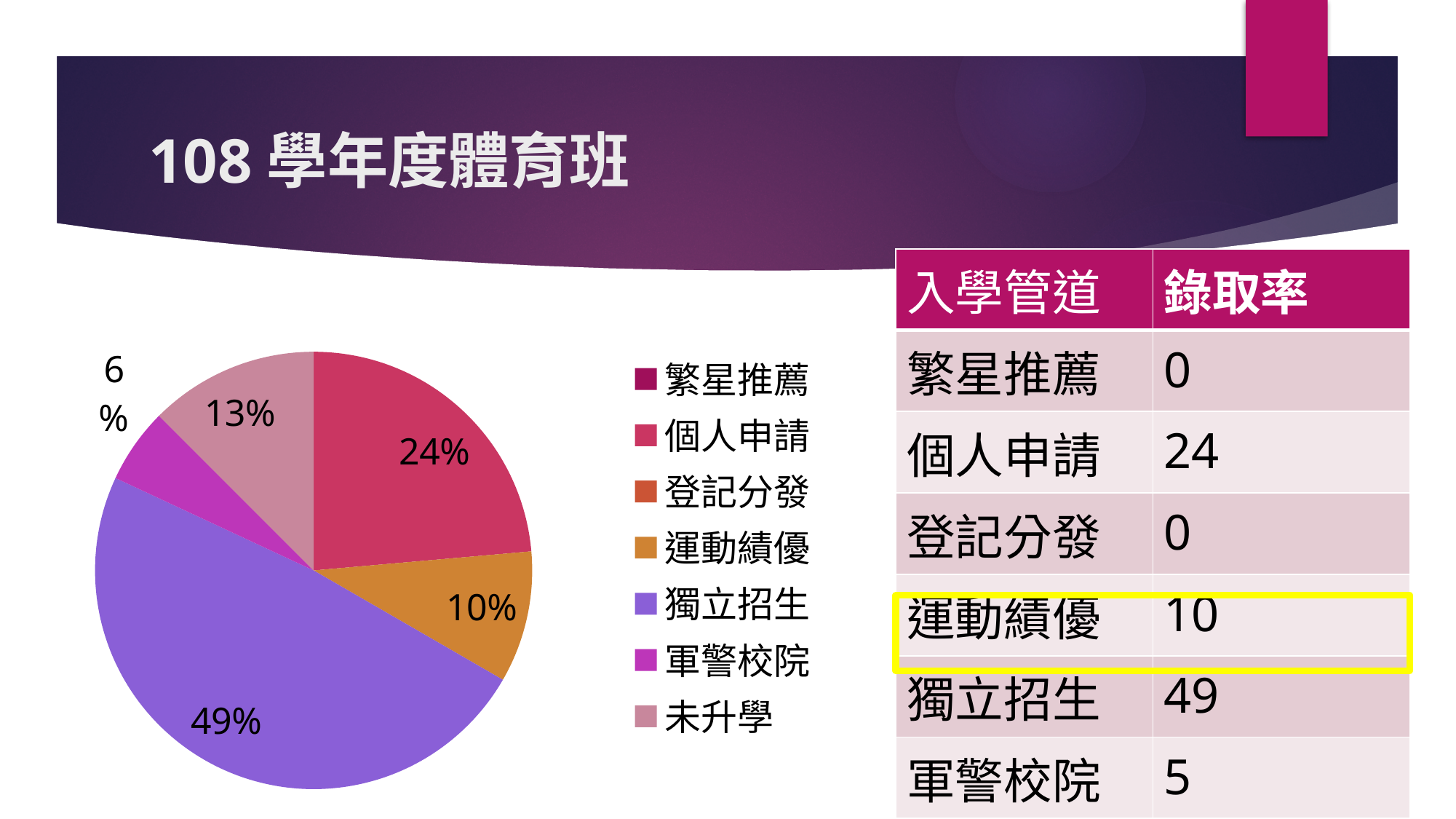
What type of chart is shown on the slide? pie chart What is the difference in percentage points between the 獨立招生 slice and the 個人申請 slice? 25% What percentage is shown for 運動績優 in the pie chart? 10% What is the title of the slide containing the pie chart? 108 學年度體育班 What percentage of the pie chart does 獨立招生 account for? 49% Which category has the largest slice in the pie chart? 獨立招生 Which labelled slice in the pie chart is the smallest? 軍警校院 How many entries does the legend of the pie chart list? 7 What percentage is shown for 軍警校院 in the pie chart? 6% What percentage is shown for 未升學 in the pie chart? 13% What percentage is shown for 個人申請 in the pie chart? 24% Which slice is larger in the pie chart, 未升學 or 運動績優? 未升學